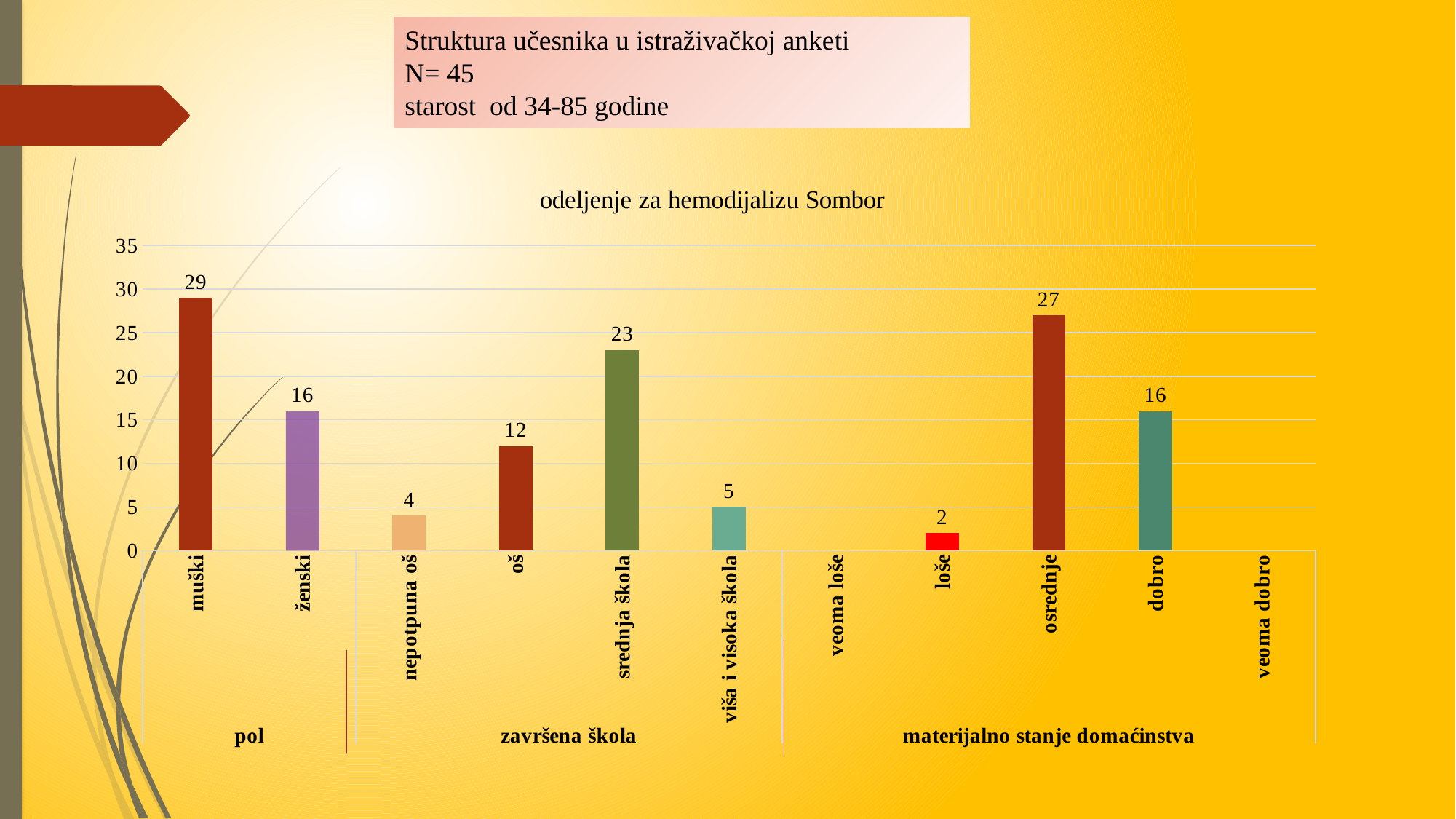
What is the value for nepotpuna oš? 4 How many category labels are shown on the x axis? 11 What is the value for srednja škola? 23 What kind of chart is shown? bar chart What is the difference between the values for muški and ženski? 13 What is the value for muški? 29 Which is larger, the value for oš or the value for viša i visoka škola? oš Which category has the highest value? muški What is the title of the chart? odeljenje za hemodijalizu Sombor What is the difference between the values for osrednje and dobro? 11 What is the value for osrednje? 27 Which category with a visible bar has the lowest value? loše